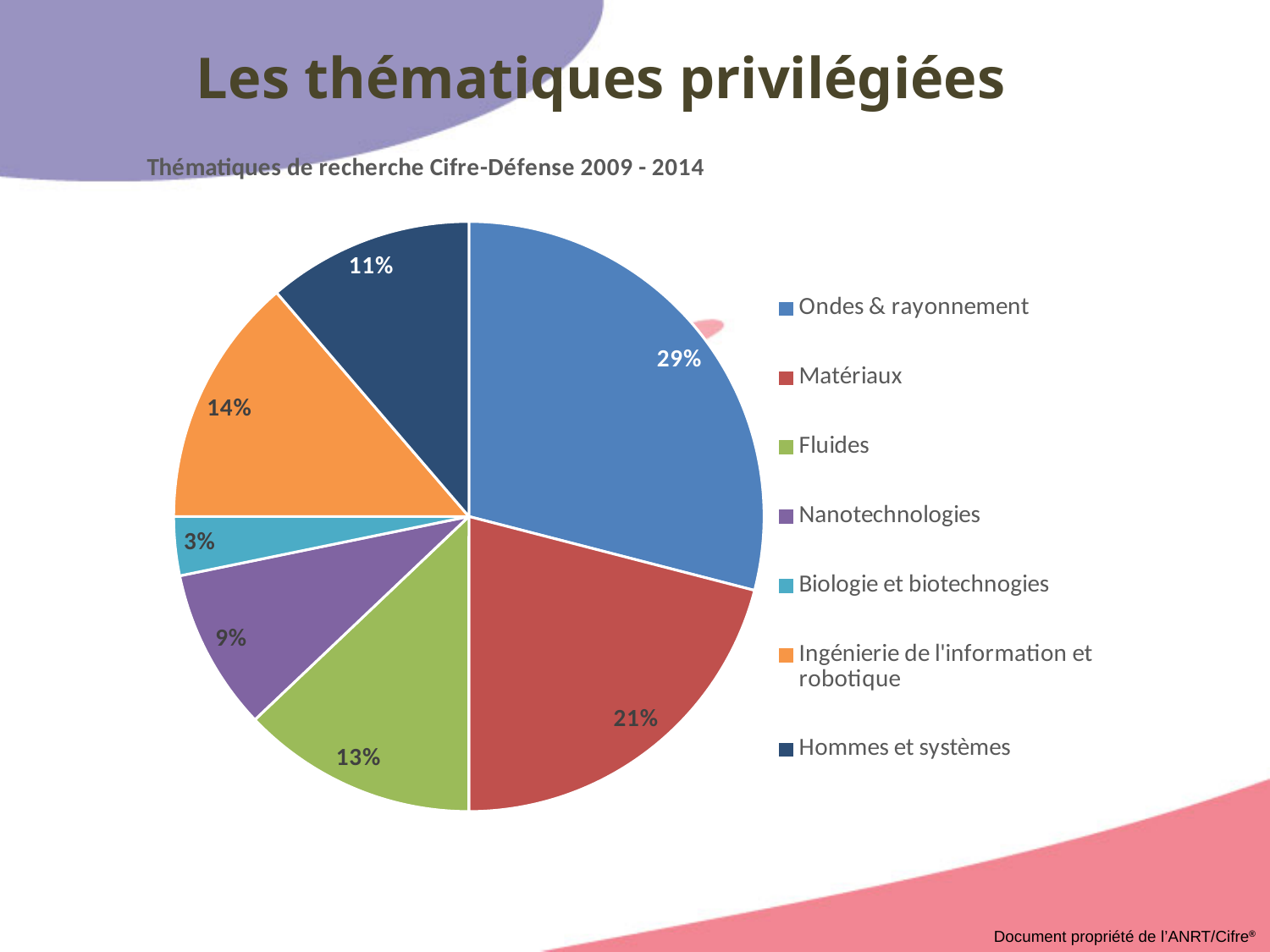
What is the chart's title? Thématiques de recherche Cifre-Défense 2009 - 2014 What type of chart is shown on the slide? pie chart Which category has the smallest share of the pie? Biologie et biotechnogies What share of the pie does Ondes & rayonnement represent? 29% Which is larger, the share for Nanotechnologies or the share for Fluides? Fluides What percentage is shown for Matériaux? 21% What percentage is shown for Hommes et systèmes? 11% What is the difference in percentage points between Ondes & rayonnement and Matériaux? 8 What percentage is shown for Ingénierie de l'information et robotique? 14% Which category has the largest share of the pie? Ondes & rayonnement What percentage is shown for Fluides? 13% How many categories does the legend list? 7